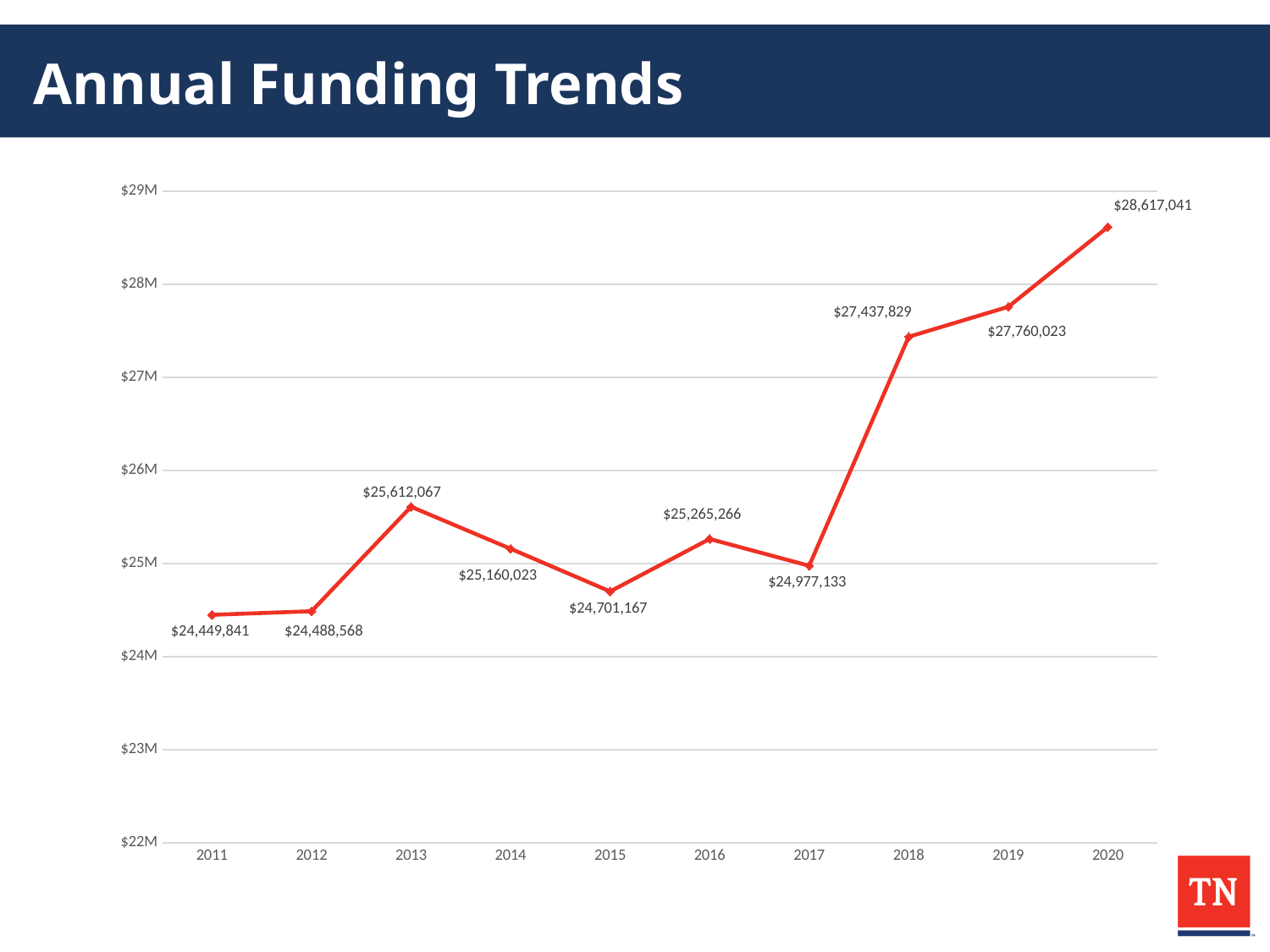
What is the difference between the funding values for 2020 and 2011? $4,167,200 Which year has the larger funding value, 2014 or 2016? 2016 What is the funding value for 2013? $25,612,067 What is the difference between the funding values for 2019 and 2018? $322,194 Which year has the lowest funding value? 2011 Does the funding value generally rise or fall from 2011 to 2020? rise How many years are plotted on the chart? 10 Is the funding value for 2017 greater or less than $25M? less What is the funding value for 2015? $24,701,167 What kind of chart is shown on the slide? line chart Which year has the highest funding value? 2020 What is the funding value for 2018? $27,437,829